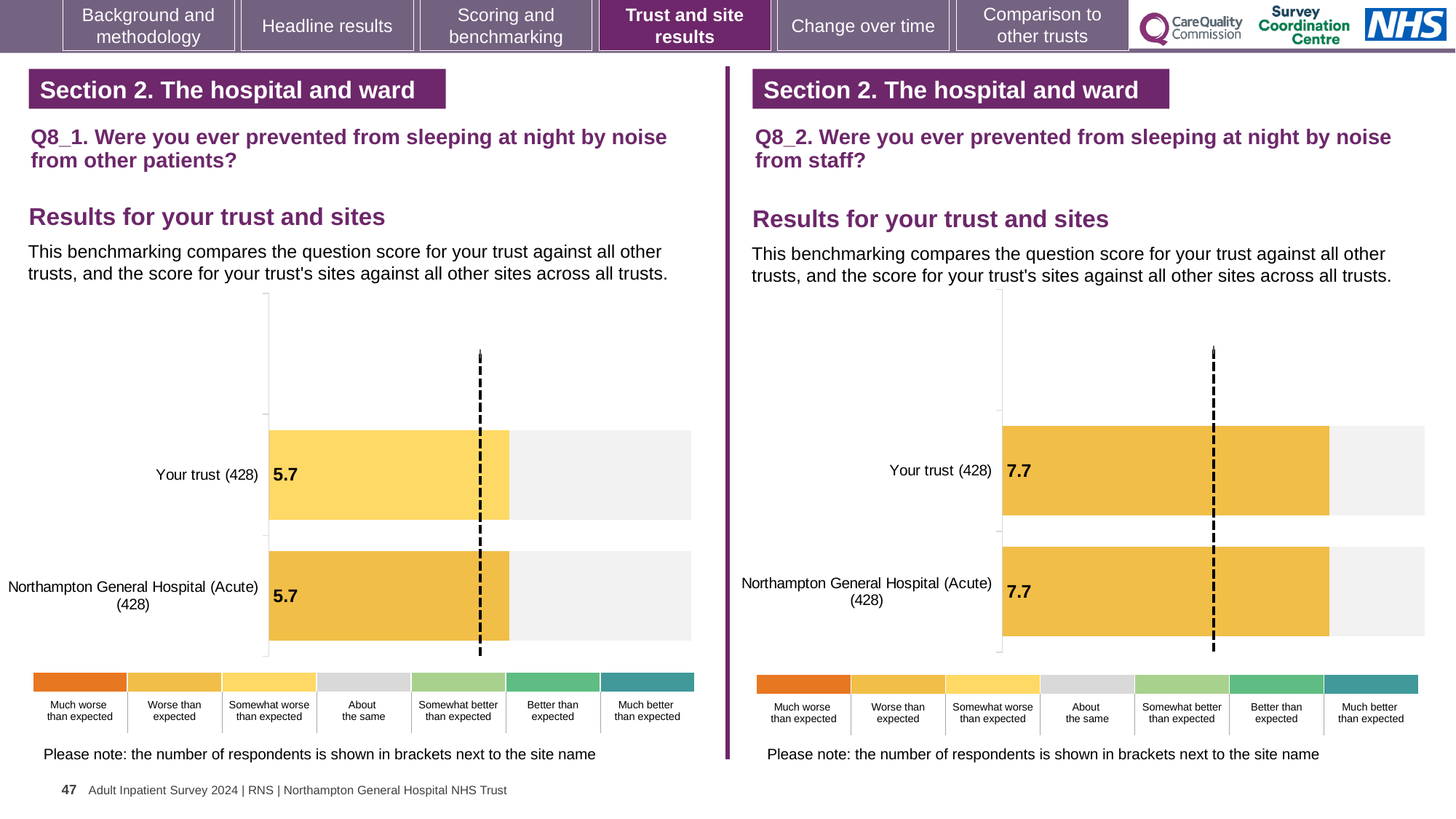
What kind of chart is used for the Q8_1 results on the left? Bar chart How many categories does the colour key below the Q8_2 chart (right) list? 7 In the Q8_1 chart (left), what is the score for Northampton General Hospital (Acute)? 5.7 In the Q8_2 chart (right), what is the score for Northampton General Hospital (Acute)? 7.7 What is the difference between the Your trust score in the Q8_2 chart (right) and the Your trust score in the Q8_1 chart (left)? 2.0 Is the score for Your trust higher in the Q8_1 chart (left) or in the Q8_2 chart (right)? Q8_2 chart (right) In the Q8_1 chart (left), which colour-key category does the Your trust bar's colour correspond to? Somewhat worse than expected How many bars are plotted in the Q8_1 chart (left)? 2 In the Q8_2 chart (right), what is the score for Your trust? 7.7 How many bars are plotted in the Q8_2 chart (right)? 2 In the Q8_1 chart (left), what is the score for Your trust? 5.7 How many respondents are shown in brackets next to Your trust in the Q8_1 chart (left)? 428